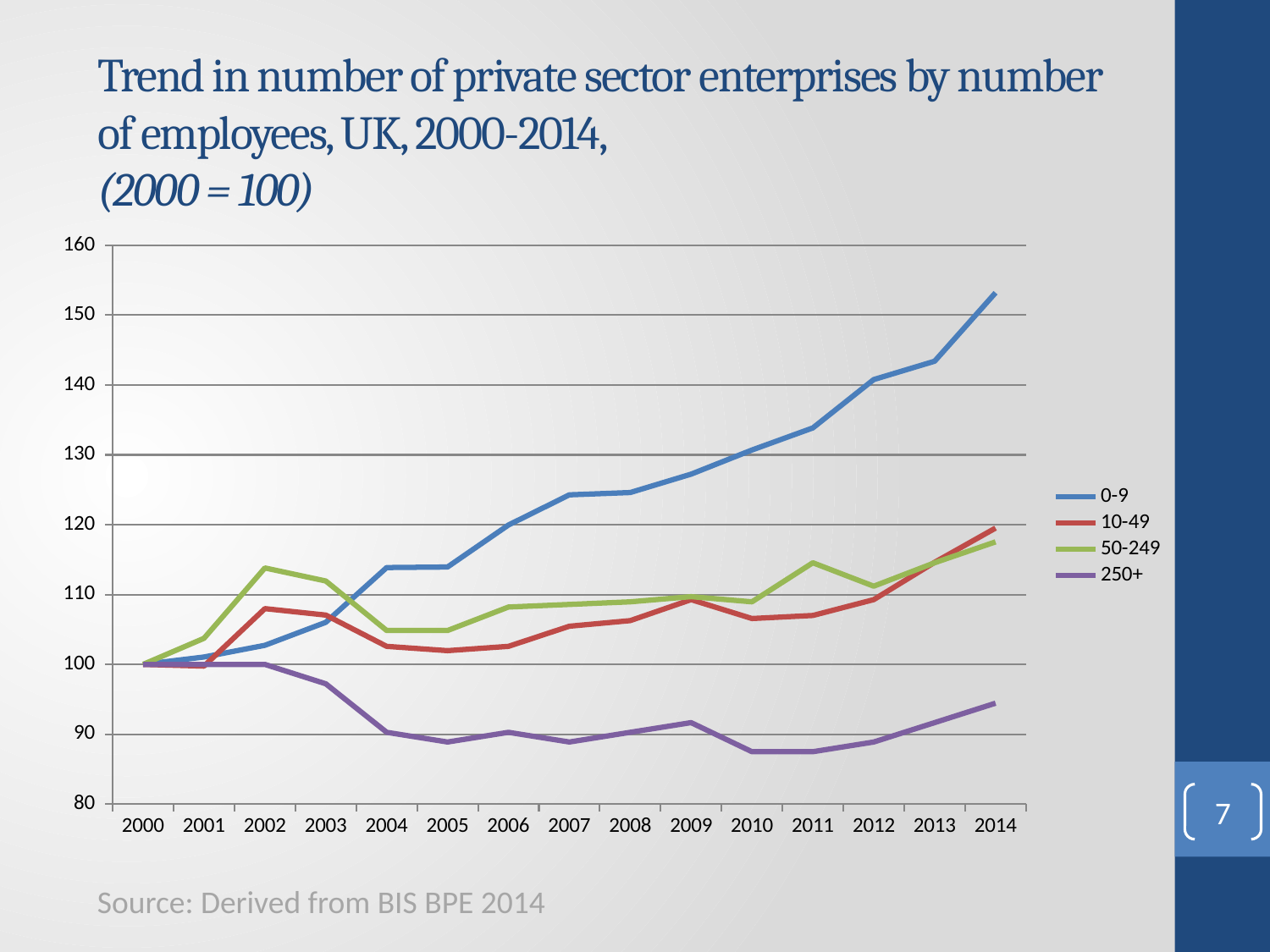
Is the value for the 250+ series in 2014 greater or less than 100? less Is the value for the 250+ series in 2010 greater or less than 90? less Does the 0-9 series generally rise or fall from 2000 to 2014? Rise Is the value for the 50-249 series in 2002 greater or less than 110? greater How many series does the legend list? 4 Which series is drawn in purple in the legend? 250+ How many years are shown along the x axis? 15 Which series has the lowest value in 2014? 250+ What is the value for every series in 2000? 100 Which series has the highest value in 2014? 0-9 What kind of chart is shown on the slide? Line chart